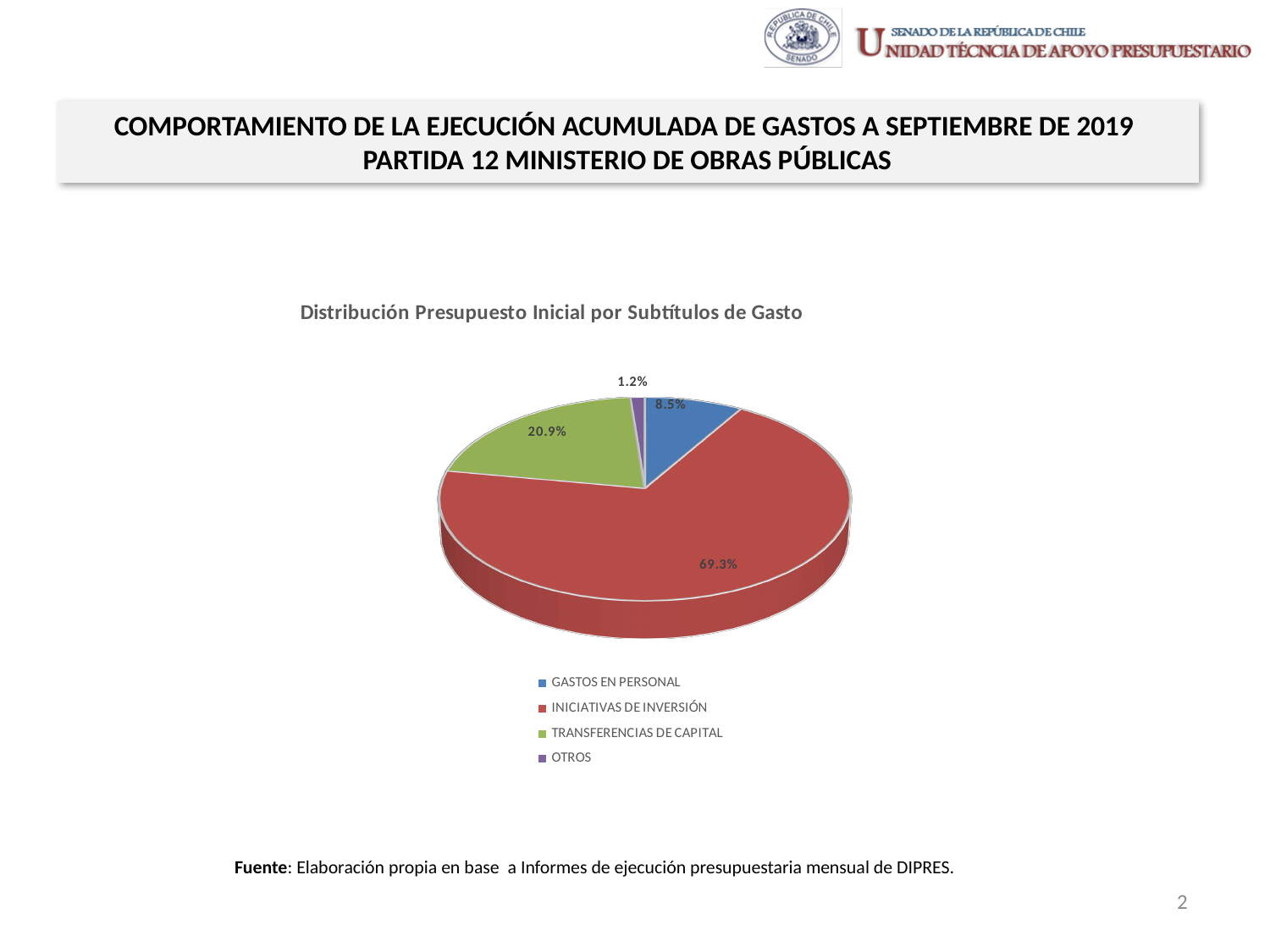
What share of the pie does TRANSFERENCIAS DE CAPITAL represent? 20.9% What share of the pie does INICIATIVAS DE INVERSIÓN represent? 69.3% Which category has the largest share of the pie? INICIATIVAS DE INVERSIÓN What share of the pie does GASTOS EN PERSONAL represent? 8.5% What colour is the slice for TRANSFERENCIAS DE CAPITAL? Green Which category has the smallest share of the pie? OTROS What type of chart is shown on the slide? Pie chart What is the difference in percentage points between INICIATIVAS DE INVERSIÓN and TRANSFERENCIAS DE CAPITAL? 48.4 What is the title of the chart? Distribución Presupuesto Inicial por Subtítulos de Gasto Which is larger, the share for GASTOS EN PERSONAL or the share for TRANSFERENCIAS DE CAPITAL? TRANSFERENCIAS DE CAPITAL How many categories does the pie chart show? 4